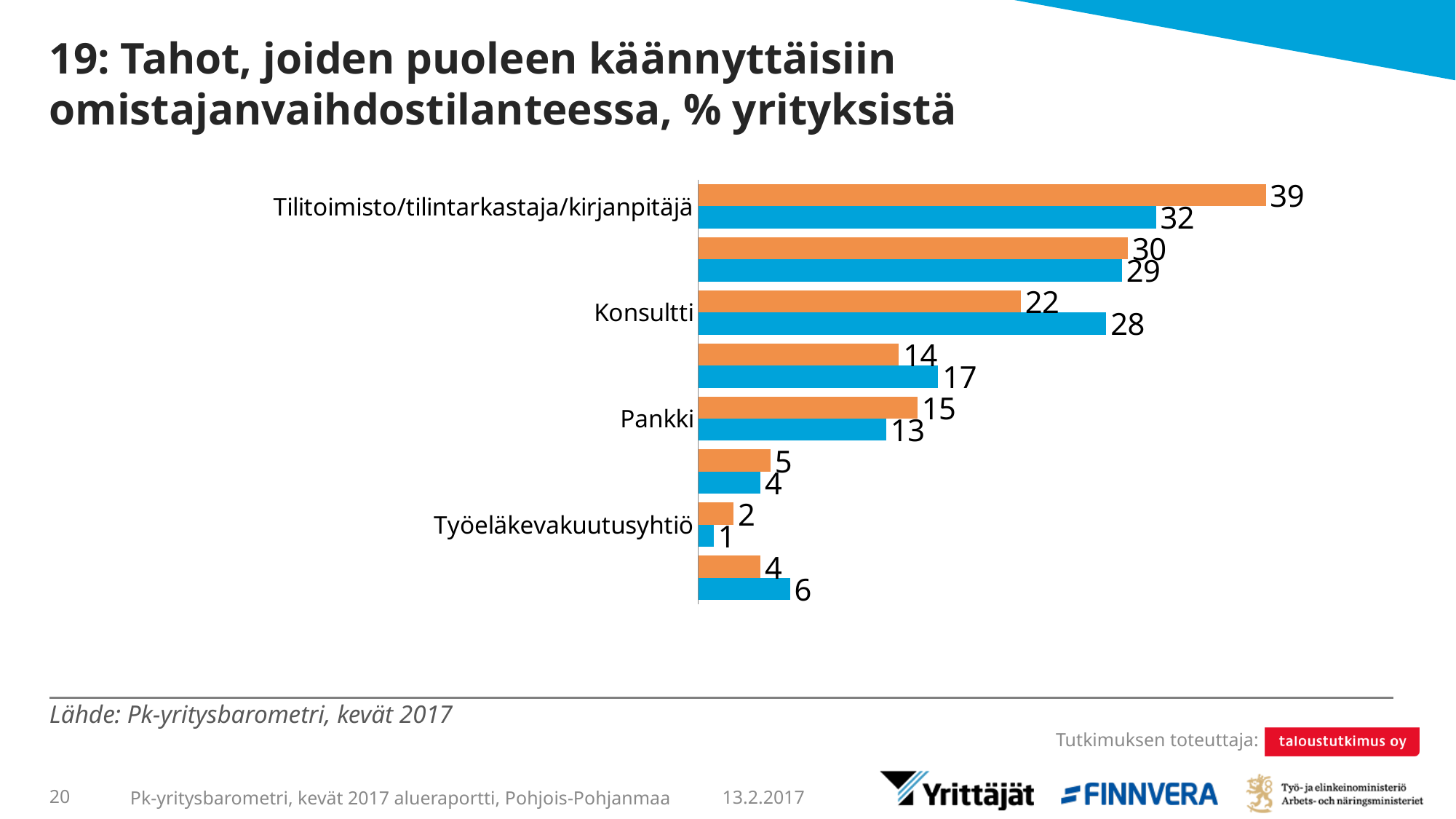
What is the value of the blue bar for Työeläkevakuutusyhtiö? 1 How many data series are plotted in the chart? 2 What type of chart is shown on the slide? bar chart Which labelled category has the lowest blue bar value? Työeläkevakuutusyhtiö What is the value of the orange bar for Pankki? 15 What is the value of the blue bar for Tilitoimisto/tilintarkastaja/kirjanpitäjä? 32 For Pankki, which bar is larger, the orange or the blue one? orange Which labelled category has the highest orange bar value? Tilitoimisto/tilintarkastaja/kirjanpitäjä What is the value of the blue bar for Konsultti? 28 What is the difference between the orange and blue bar values for Konsultti? 6 What is the value of the orange bar for Tilitoimisto/tilintarkastaja/kirjanpitäjä? 39 How many pairs of bars (categories) are plotted in the chart? 8